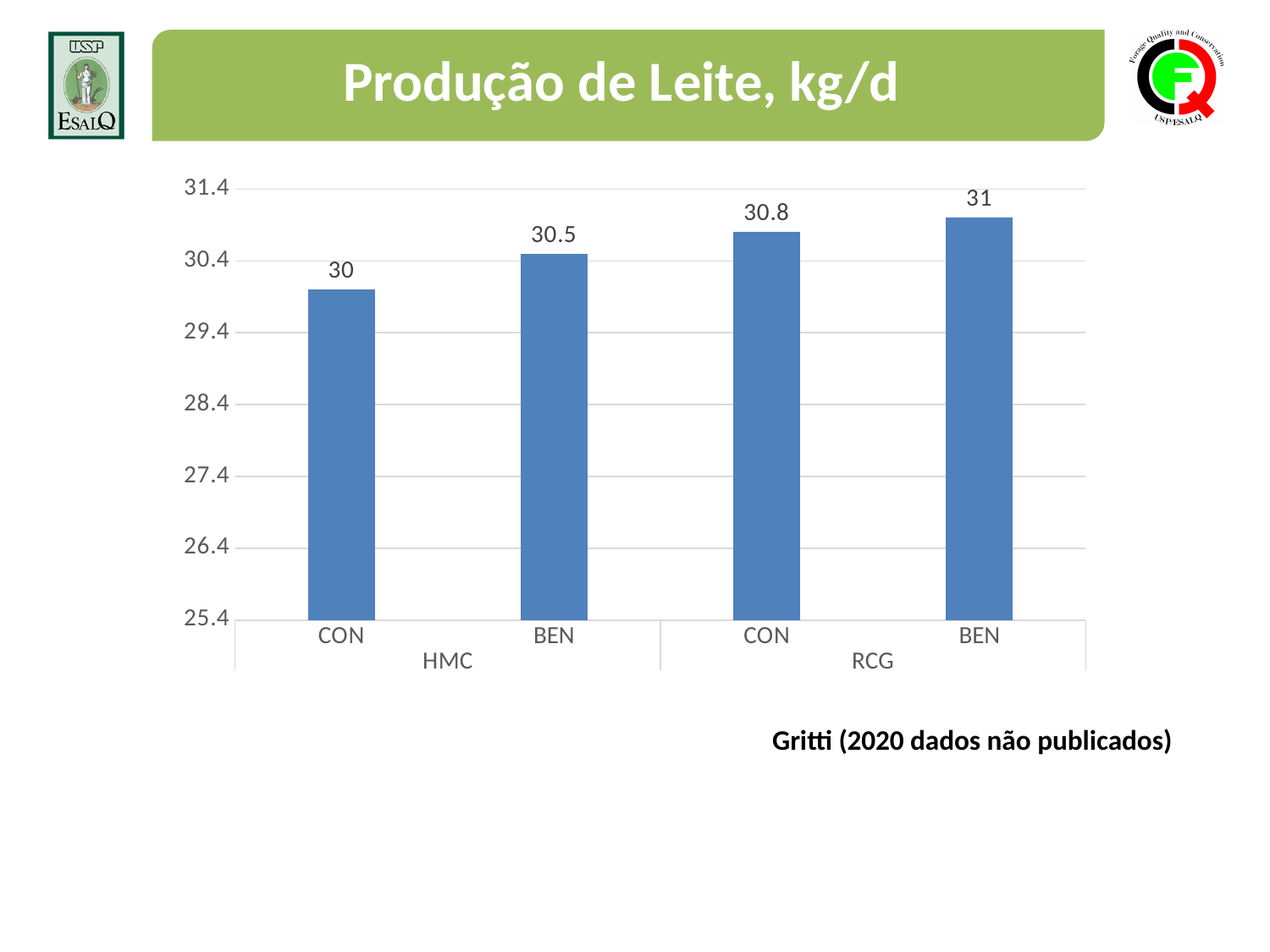
Which bar has the highest milk production value? BEN in RCG Which is larger, the BEN value in HMC or the CON value in RCG? CON in RCG What is the difference between the RCG CON value and the HMC CON value? 0.8 What is the milk production value for BEN in the HMC group? 30.5 What is the difference between the BEN and CON values in the HMC group? 0.5 How many bars are plotted in the chart? 4 What is the milk production value for BEN in the RCG group? 31 What is the title of the chart? Produção de Leite, kg/d What kind of chart is shown on the slide? Bar chart What is the milk production value for CON in the HMC group? 30 What is the milk production value for CON in the RCG group? 30.8 Which bar has the lowest milk production value? CON in HMC